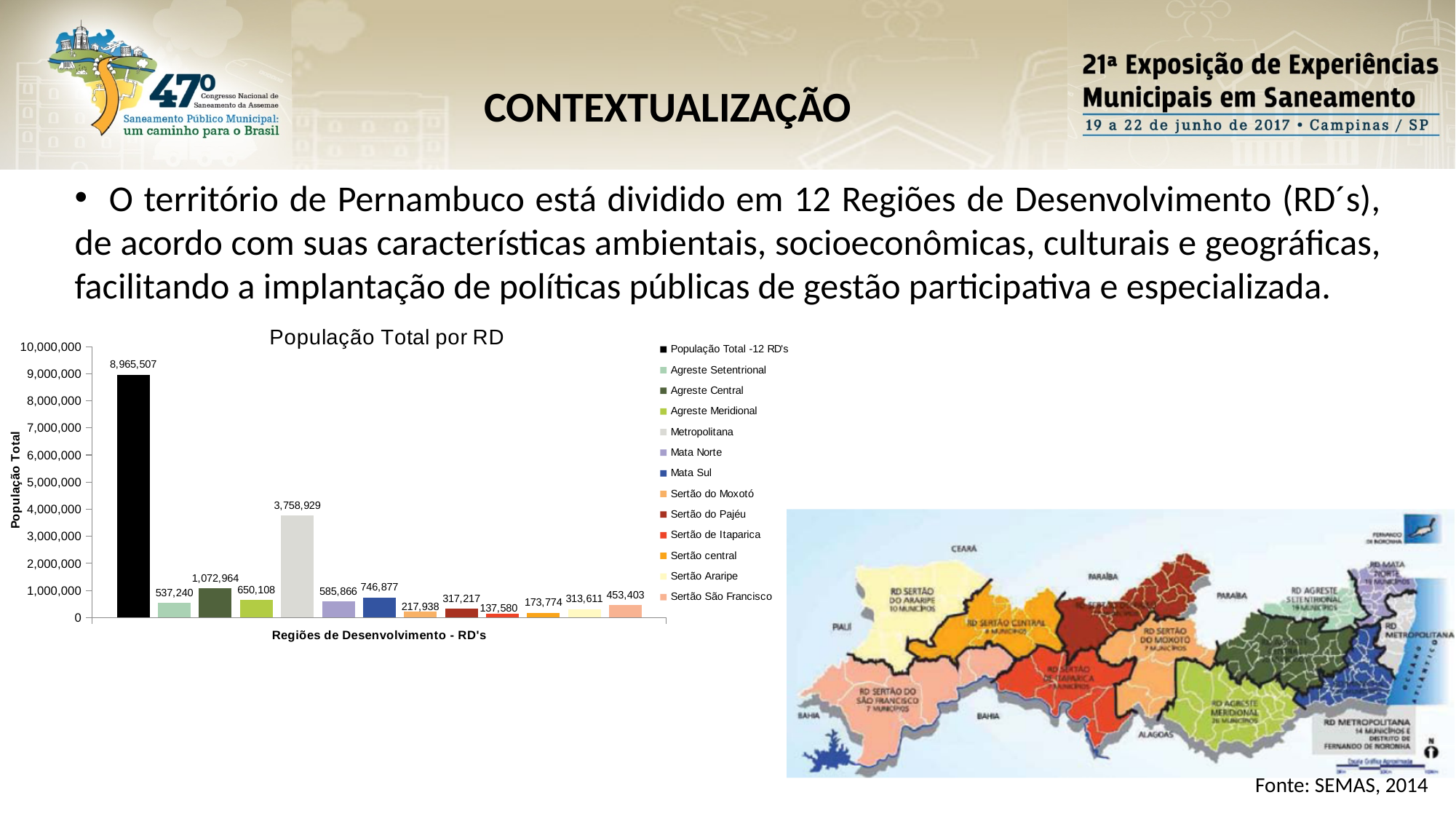
What is the value shown for Metropolitana in the chart? 3,758,929 How many entries does the legend of the chart list? 13 What type of chart is shown on the slide? bar chart What is the title of the chart on the slide? População Total por RD What is the value shown for Agreste Central in the chart? 1,072,964 What is the value shown for População Total -12 RD's in the chart? 8,965,507 Which is larger in the chart, Mata Sul or Mata Norte? Mata Sul What is the difference between the values for Agreste Meridional and Agreste Setentrional in the chart? 112,868 What is the value shown for Sertão de Itaparica in the chart? 137,580 Is the value for Sertão São Francisco greater or less than 1,000,000 in the chart? less Which region (excluding the total bar) has the highest population in the chart? Metropolitana Which region has the lowest population in the chart? Sertão de Itaparica